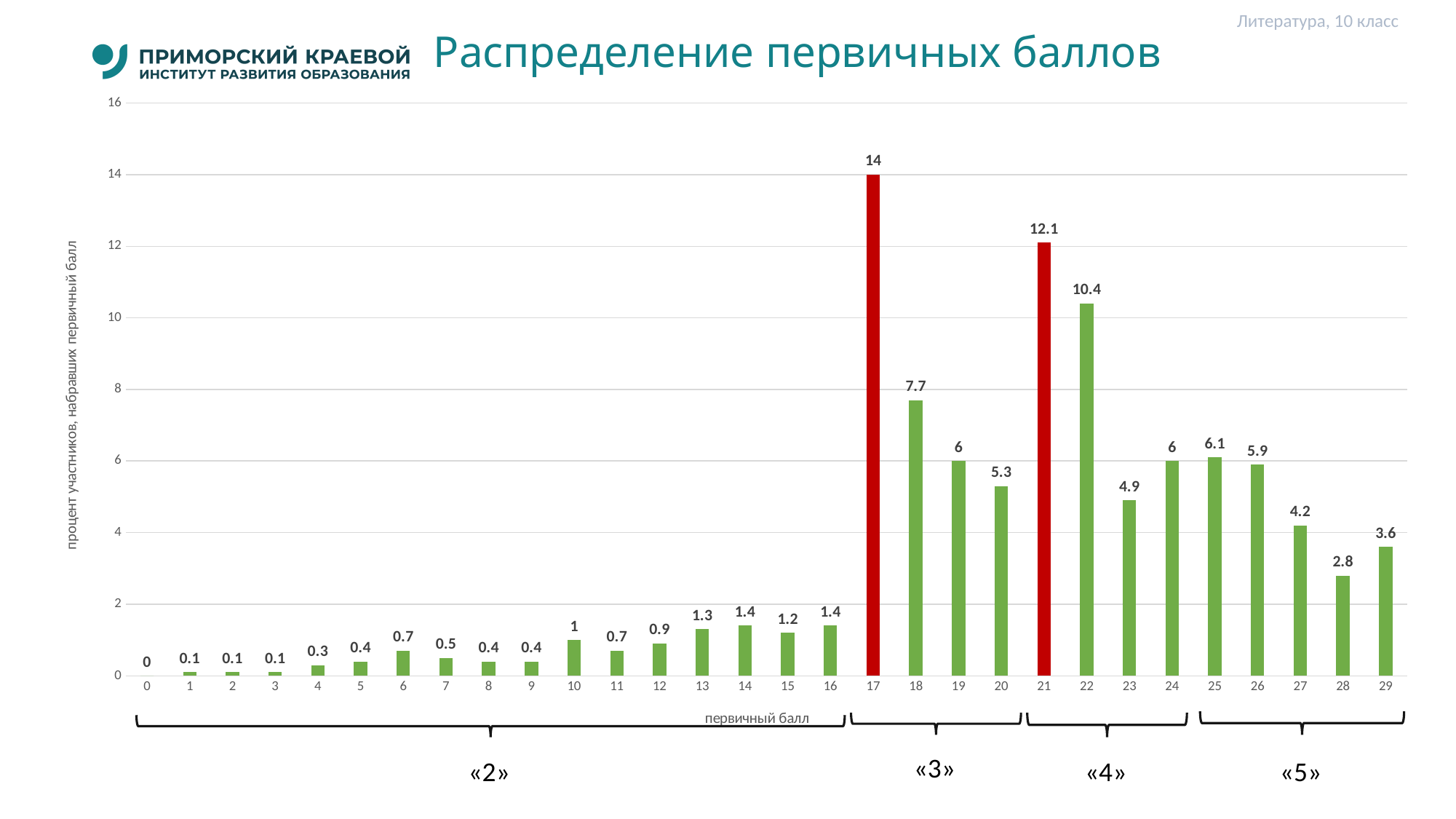
Which two primary scores are shown with red bars? 17 and 21 Which primary score has the highest percentage of participants? 17 Do the values rise or fall from primary score 25 to primary score 28? fall What is the value for primary score 17? 14 What is the value for primary score 28? 2.8 Which primary score has the lowest percentage of participants? 0 What type of chart is shown on the slide? bar chart What is the title of the chart? Распределение первичных баллов Which has a larger value, primary score 18 or primary score 22? 22 How many primary score categories are shown on the x axis? 30 What is the value for primary score 22? 10.4 What is the difference between the values for primary scores 17 and 21? 1.9